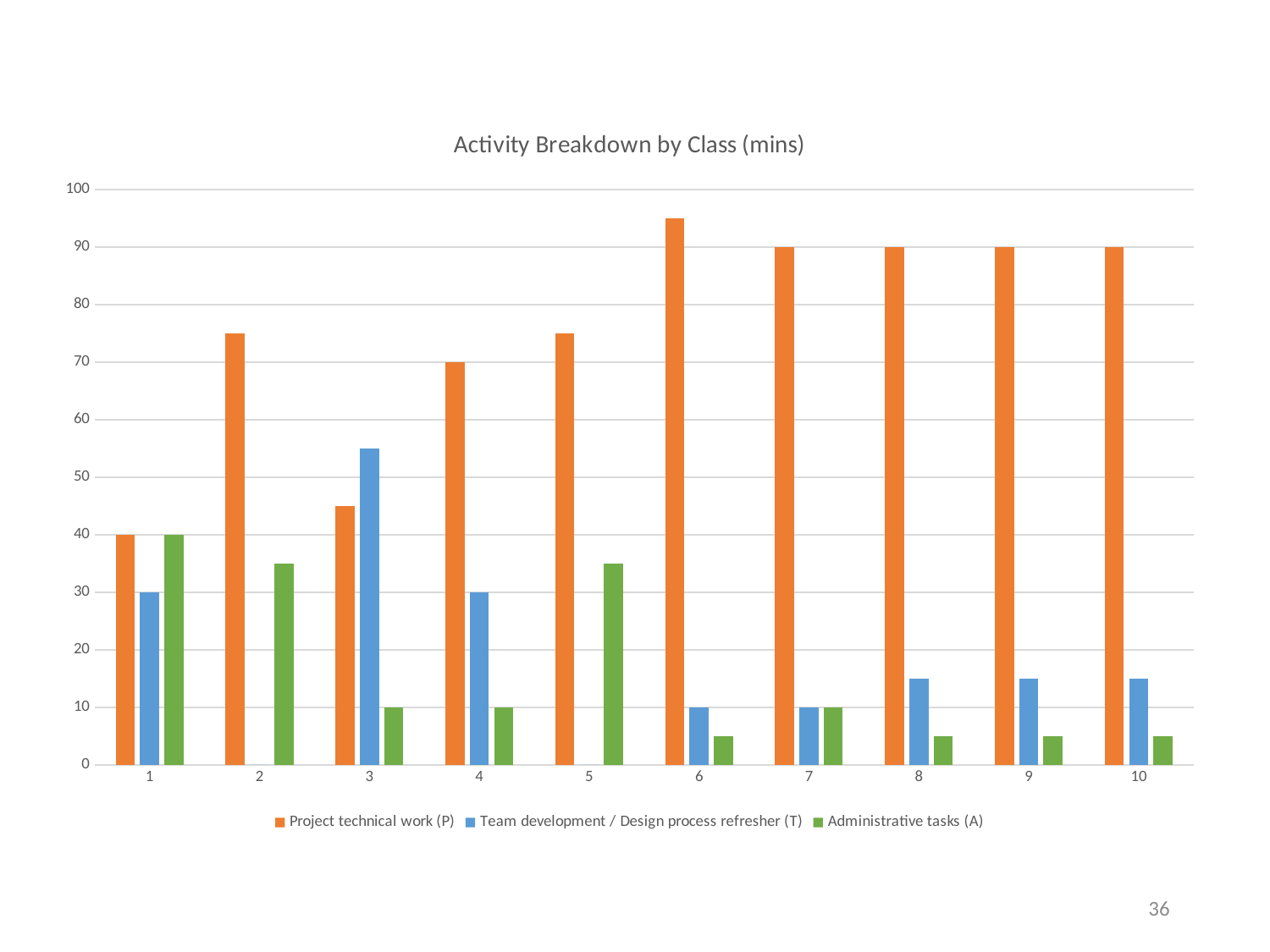
How many classes are shown on the x axis? 10 Which class has the highest value for Project technical work (P)? 6 What is the value for Administrative tasks (A) in class 7? 10 In class 3, which is larger: Project technical work (P) or Team development / Design process refresher (T)? Team development / Design process refresher (T) What is the value for Team development / Design process refresher (T) in class 4? 30 What kind of chart is shown on the slide? bar chart Is the value for Team development / Design process refresher (T) in class 3 greater or less than 50? greater What is the difference between Project technical work (P) and Team development / Design process refresher (T) in class 1? 10 How many series does the legend list? 3 What is the value for Project technical work (P) in class 1? 40 Which class has the lowest value for Project technical work (P)? 1 What is the title of the chart? Activity Breakdown by Class (mins)